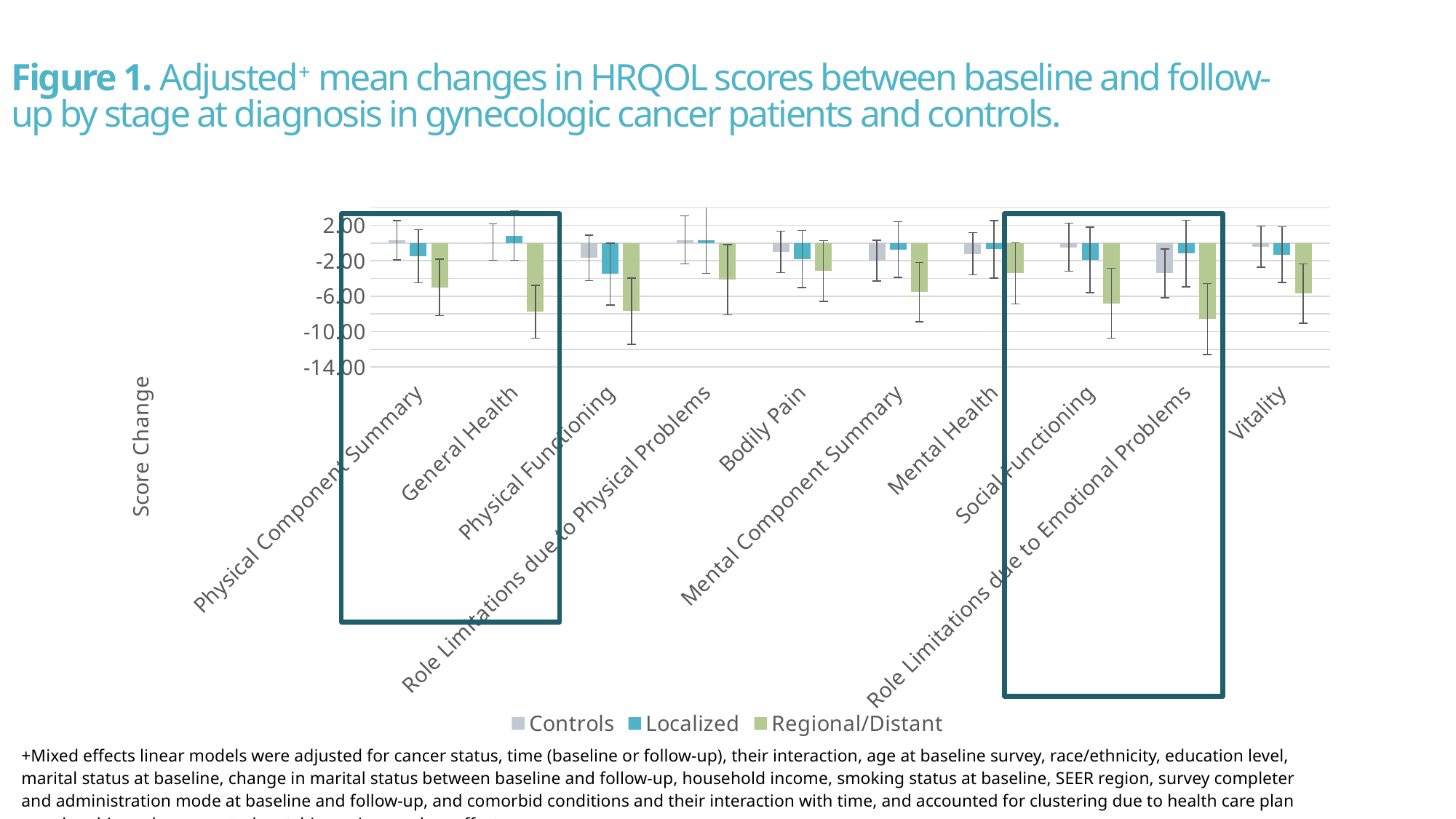
For General Health, which is larger: the Localized value or the Regional/Distant value? Localized What is the label on the vertical axis of the chart? Score Change For Social Functioning, which series has the lowest bar? Regional/Distant How many series does the chart's legend list? 3 How many HRQOL categories are shown along the x axis of the chart? 10 Is the Regional/Distant value for Role Limitations due to Emotional Problems greater or less than -6.00? less Is the Regional/Distant value for Bodily Pain greater or less than -6.00? greater Is the Localized value for General Health greater or less than -2.00? greater What are the three series named in the legend? Controls, Localized, Regional/Distant For Role Limitations due to Emotional Problems, which is larger: the Controls value or the Localized value? Localized What kind of chart is shown on the slide? Bar chart